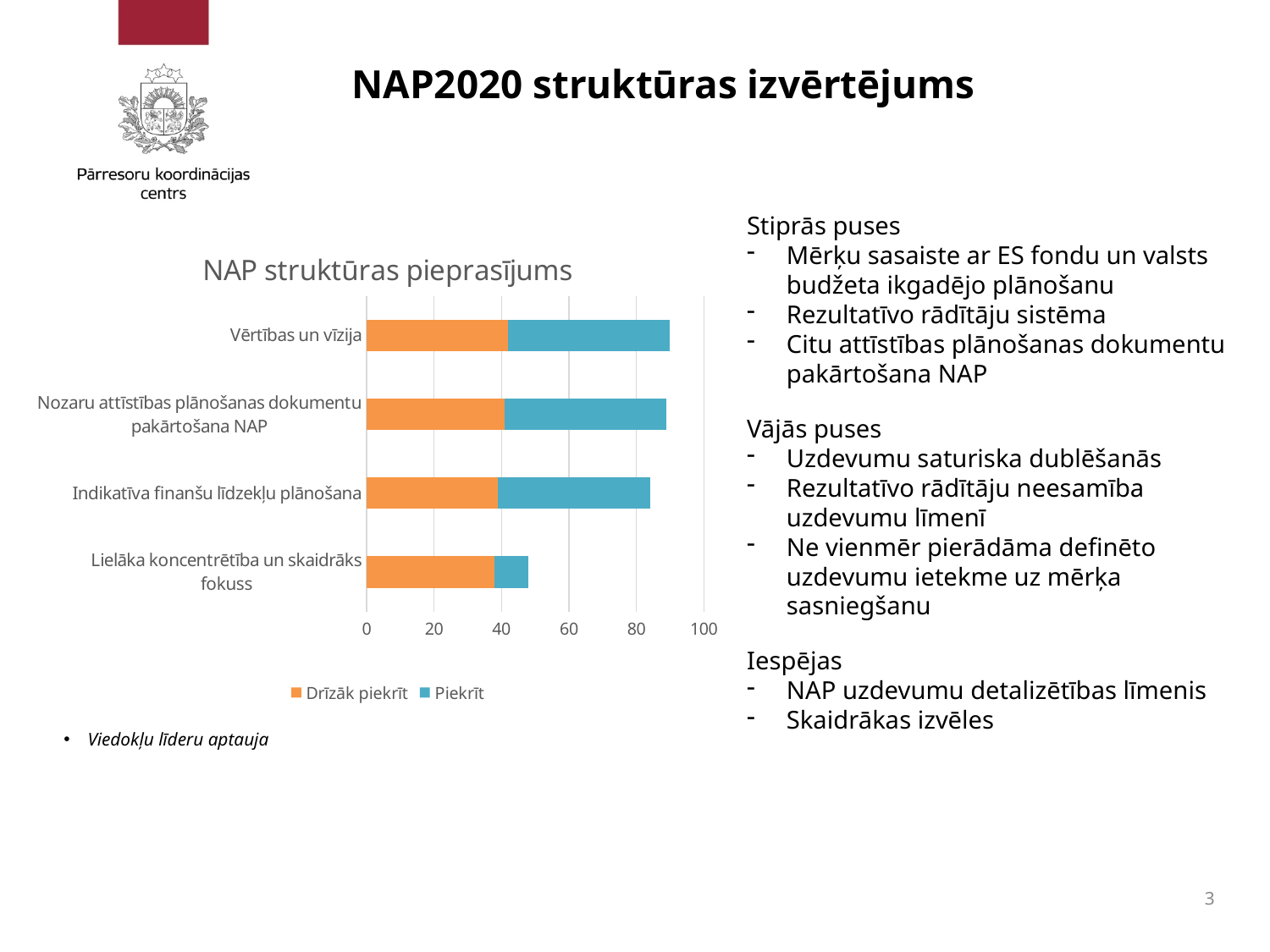
Which has the larger total bar: 'Indikatīva finanšu līdzekļu plānošana' or 'Lielāka koncentrētība un skaidrāks fokuss'? Indikatīva finanšu līdzekļu plānošana Which has the larger total bar: 'Vērtības un vīzija' or 'Lielāka koncentrētība un skaidrāks fokuss'? Vērtības un vīzija How many categories are shown on the chart? 4 Is the 'Drīzāk piekrīt' value for 'Indikatīva finanšu līdzekļu plānošana' greater or less than 60? less Which series is shown in orange? Drīzāk piekrīt Which category has the lowest total bar length? Lielāka koncentrētība un skaidrāks fokuss What is the title of the chart? NAP struktūras pieprasījums Is the 'Piekrīt' value for 'Lielāka koncentrētība un skaidrāks fokuss' greater or less than 20? less What kind of chart is shown on the slide? Stacked bar chart How many series does the legend list? 2 Is the total bar length for 'Lielāka koncentrētība un skaidrāks fokuss' greater or less than 60? less